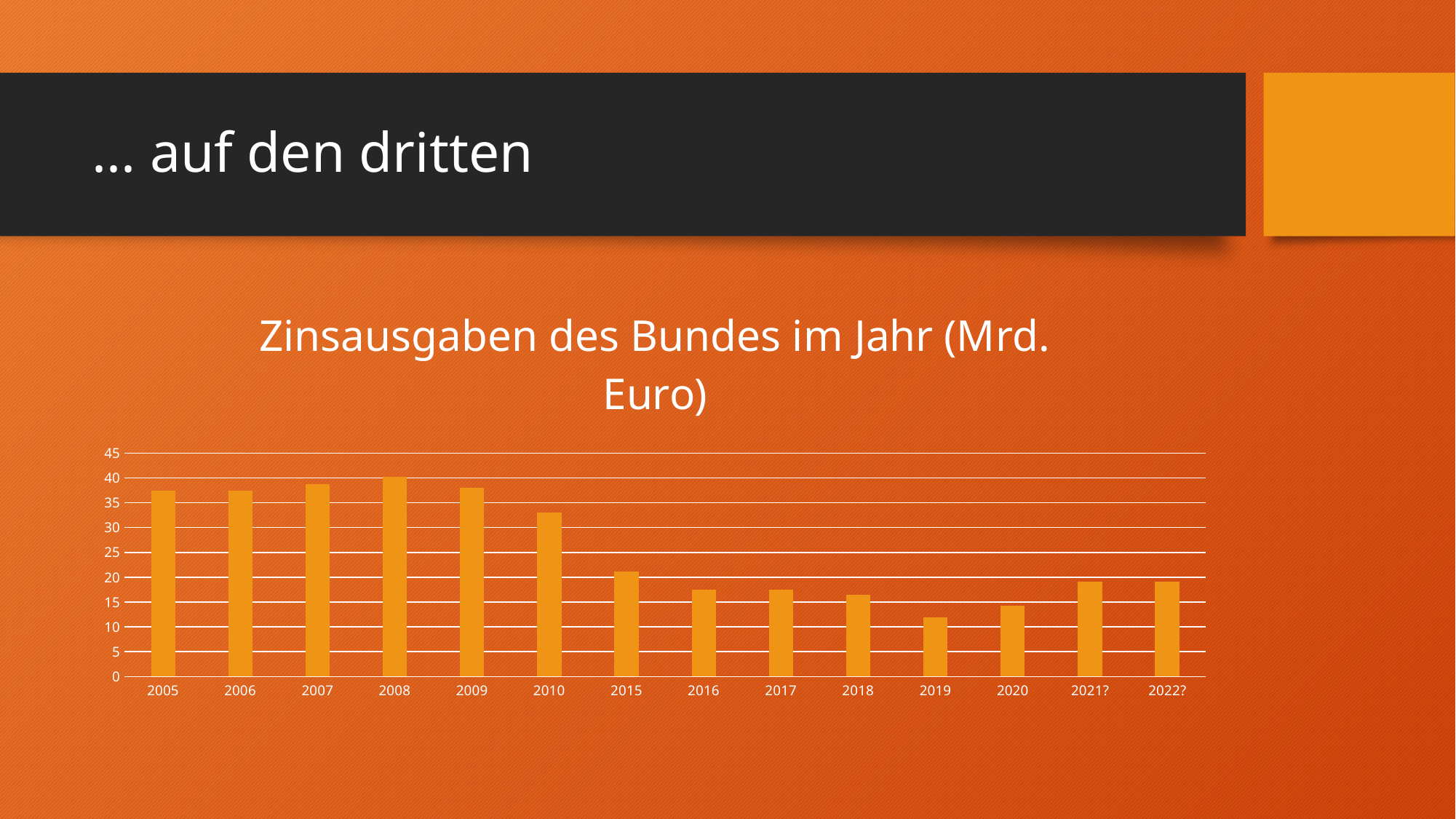
What kind of chart is shown on the slide? bar chart What is the title of the chart? Zinsausgaben des Bundes im Jahr (Mrd. Euro) Which year has the highest bar in the chart? 2008 Which year has the lowest bar in the chart? 2019 How many years (categories) are shown on the x axis of the chart? 14 Do the values generally rise or fall from 2005 to 2019? fall Is the value for 2016 greater or less than 20? less Is the value for 2010 greater or less than 30? greater Which is larger, the value for 2010 or the value for 2015? 2010 Is the value for 2005 greater or less than 35? greater Which is larger, the value for 2019 or the value for 2020? 2020